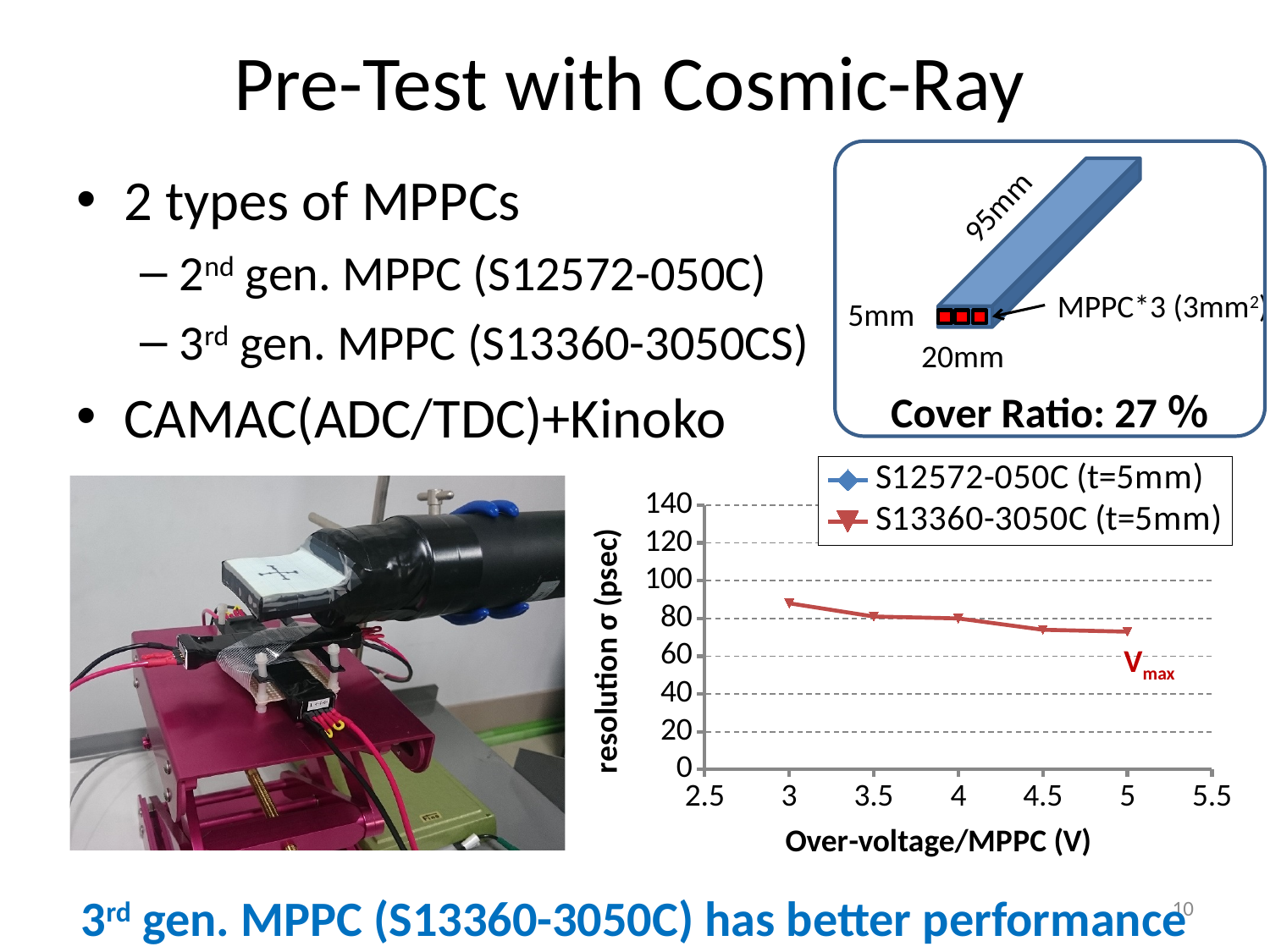
Is the resolution for S13360-3050C (t=5mm) at 4.5 V over-voltage greater or less than 60 psec? greater At which over-voltage is the resolution for S13360-3050C (t=5mm) highest? 3 V What kind of chart is shown on the slide? line chart Is the resolution for S13360-3050C (t=5mm) at 3 V over-voltage greater or less than 100 psec? less How many data points are plotted for the S13360-3050C (t=5mm) series? 5 Does the resolution for S13360-3050C (t=5mm) rise or fall as over-voltage increases along the x axis? fall Is the resolution for S13360-3050C (t=5mm) at 3 V over-voltage greater or less than 80 psec? greater Which is larger for S13360-3050C (t=5mm): the resolution at 3 V or at 5 V over-voltage? 3 V How many series does the chart legend list? 2 What is the label of the chart's x axis? Over-voltage/MPPC (V) What is the label of the chart's y axis? resolution σ (psec)